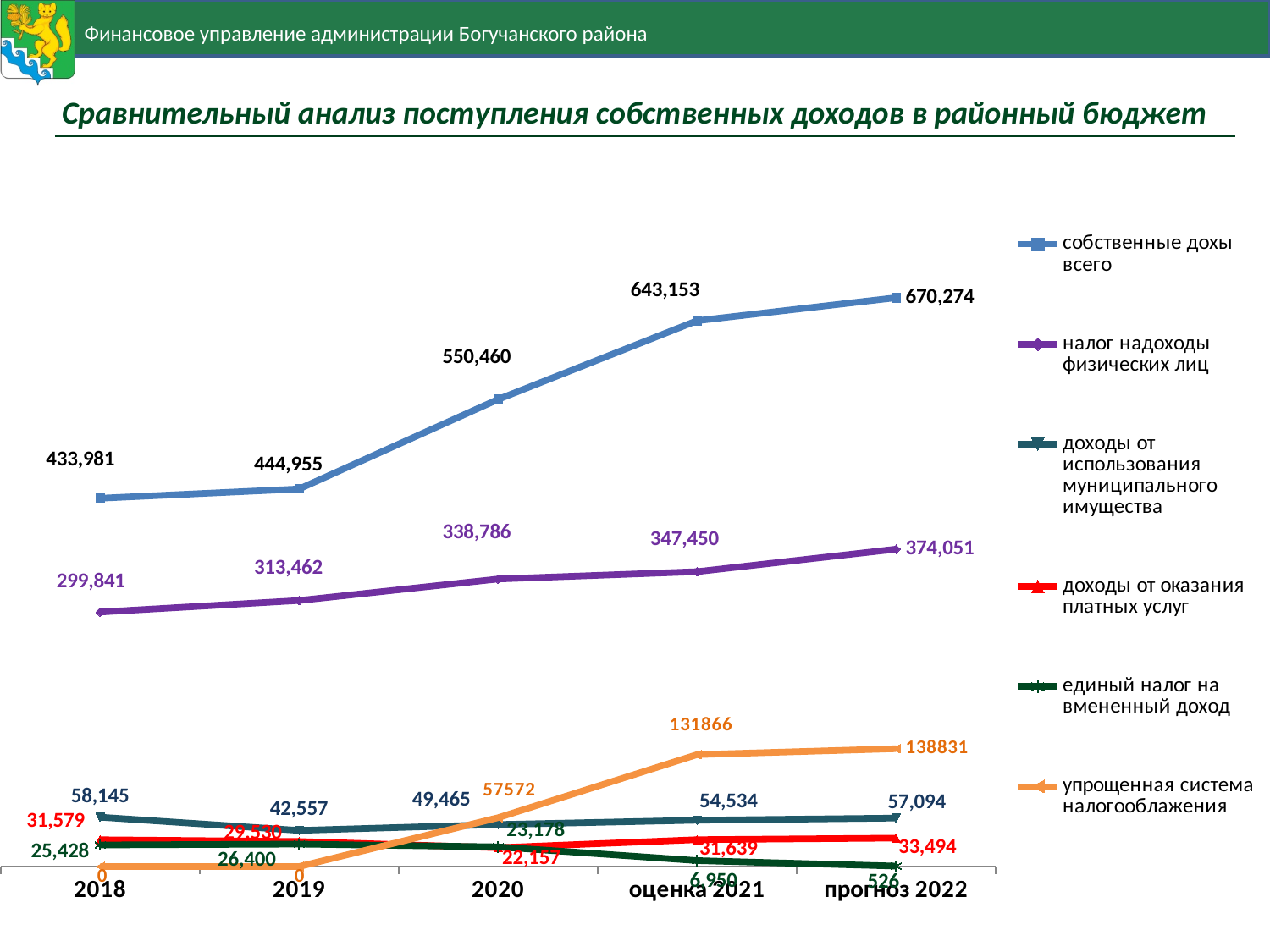
How many series does the legend list? 6 In which year is 'собственные доходы всего' lowest? 2018 In which year is 'налог на доходы физических лиц' highest? прогноз 2022 How many points along the x axis does the chart have? 5 What kind of chart is shown on the slide? line chart What is the value of 'упрощенная система налогообложения' for оценка 2021? 131866 Which is larger in 2019: 'доходы от использования муниципального имущества' or 'доходы от оказания платных услуг'? доходы от использования муниципального имущества What is the value of 'собственные доходы всего' for 2020? 550,460 Does 'собственные доходы всего' rise or fall from 2018 to прогноз 2022? rise What is the difference between 'собственные доходы всего' in прогноз 2022 and in оценка 2021? 27,121 What is the value of 'налог на доходы физических лиц' for прогноз 2022? 374,051 What is the value of 'доходы от использования муниципального имущества' for 2018? 58,145